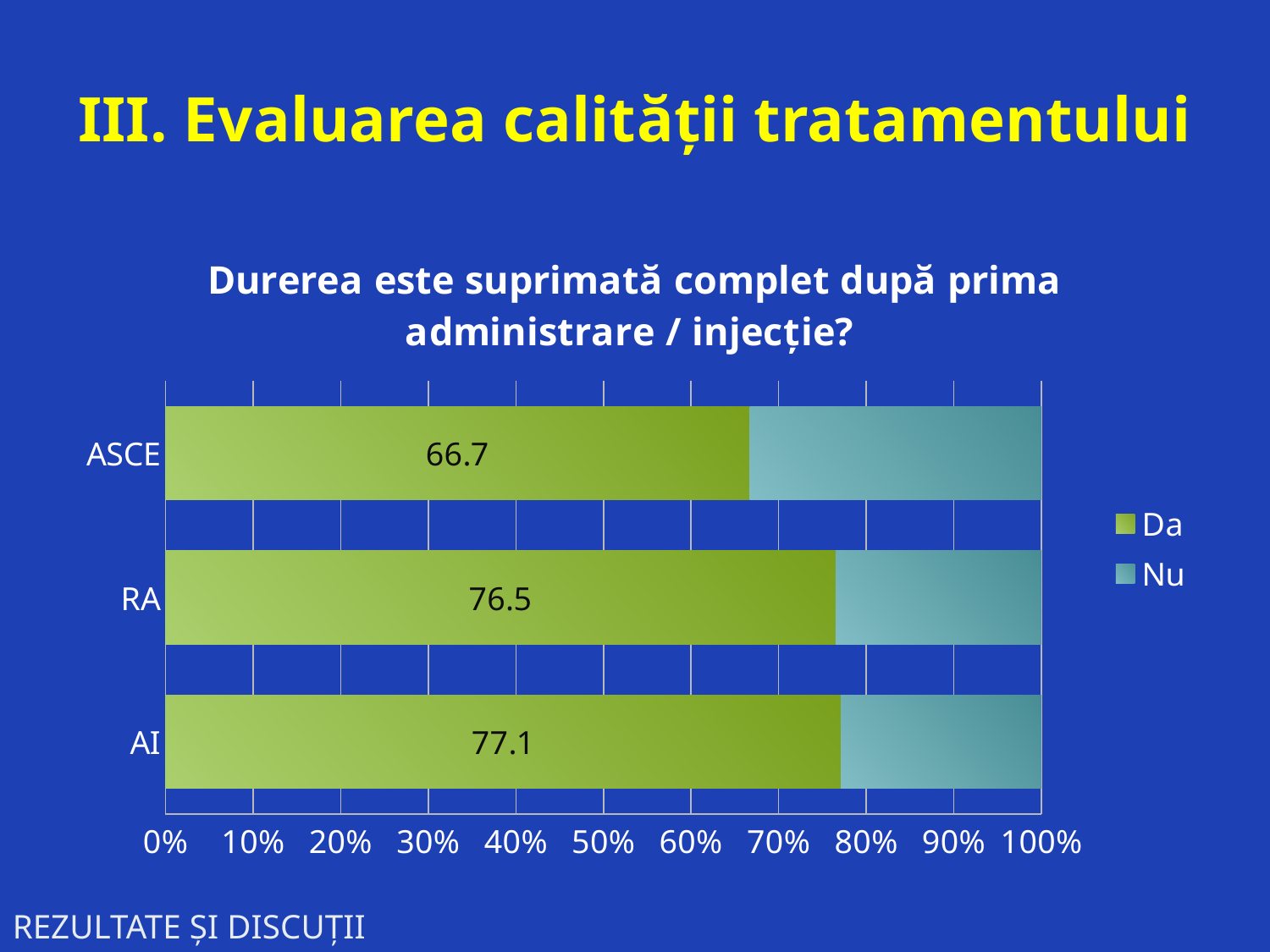
Which category has the highest "Da" value? AI How many categories are shown on the chart? 3 Is the "Nu" value for ASCE greater or less than 30%? greater What kind of chart is shown on the slide? Bar chart What is the "Da" value for AI? 77.1 What is the "Da" value for ASCE? 66.7 Which has a larger "Da" value, RA or ASCE? RA Which category has the lowest "Da" value? ASCE How many series does the legend list? 2 What is the "Da" value for RA? 76.5 Is the "Nu" value for AI greater or less than 30%? less What is the difference between the "Da" values for RA and ASCE? 9.8